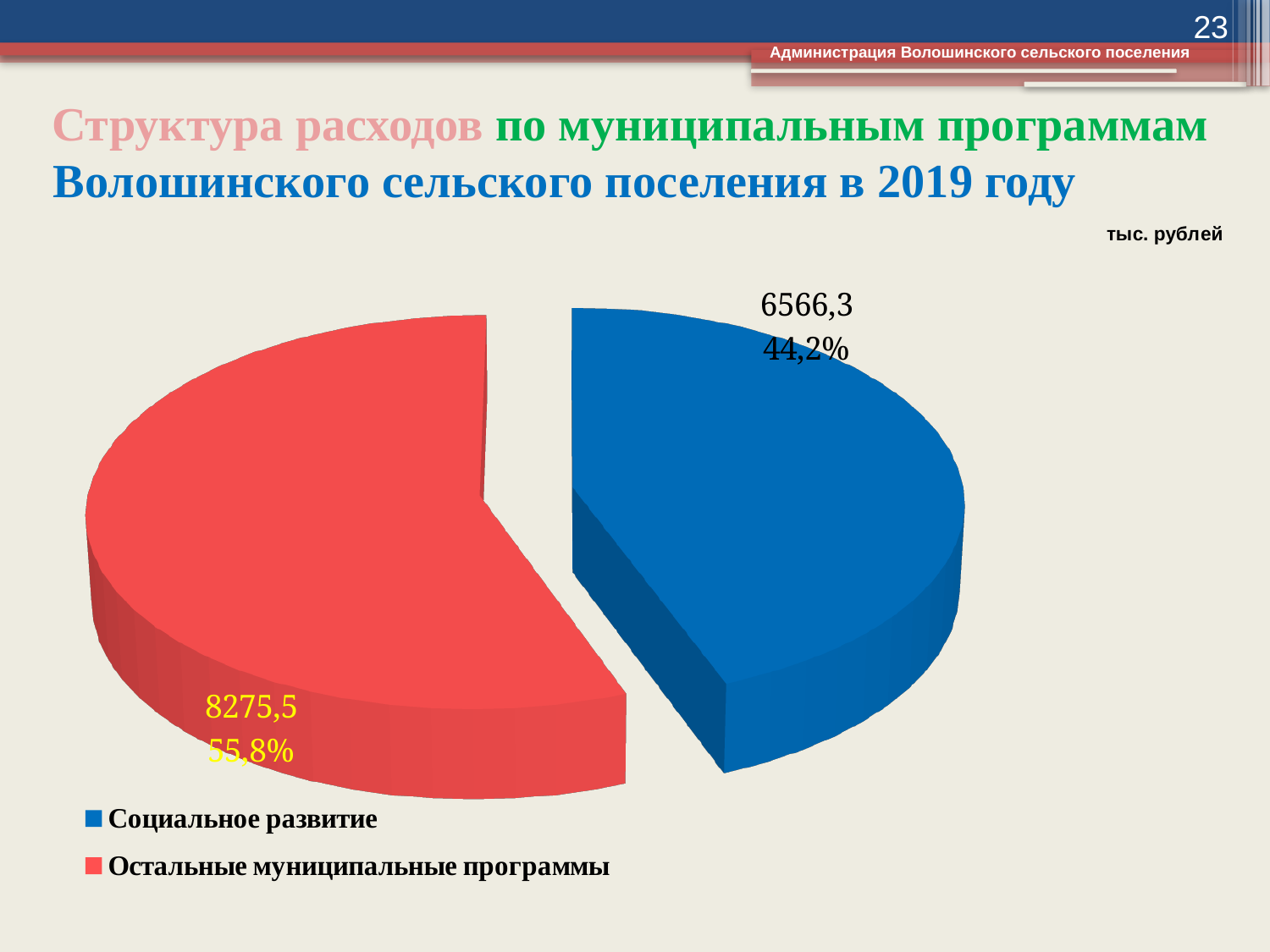
What colour is the slice for Социальное развитие? blue What is the difference between the values for Остальные муниципальные программы and Социальное развитие? 1709,2 What share of the pie does Социальное развитие take? 44,2% How many slices does the pie chart have? 2 What kind of chart is shown on the slide? pie chart Which category has the largest slice? Остальные муниципальные программы Which category has the smallest slice? Социальное развитие What share of the pie does Остальные муниципальные программы take? 55,8% What is the value for Остальные муниципальные программы? 8275,5 Which is larger: Социальное развитие or Остальные муниципальные программы? Остальные муниципальные программы What is the value for Социальное развитие? 6566,3 What unit is stated for the chart values? тыс. рублей